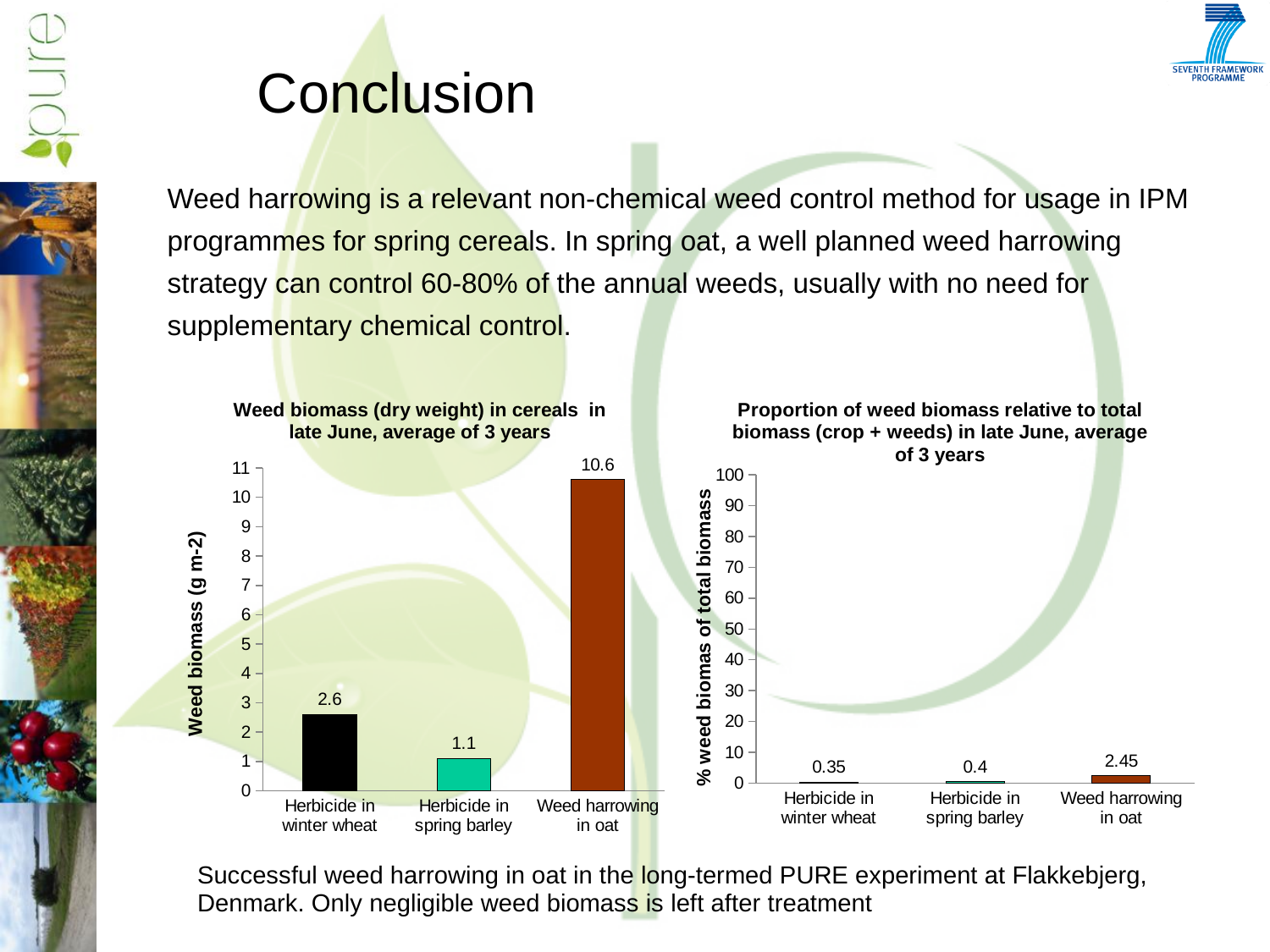
In the left chart (Weed biomass (dry weight) in cereals in late June), what is the y-axis label? Weed biomass (g m-2) In the left chart (Weed biomass (dry weight) in cereals in late June), which category has the lowest weed biomass? Herbicide in spring barley In the left chart (Weed biomass (dry weight) in cereals in late June), is the value for Weed harrowing in oat greater or less than 10? greater In the right chart (Proportion of weed biomass relative to total biomass), what is the value for Herbicide in winter wheat? 0.35 In the left chart (Weed biomass (dry weight) in cereals in late June), what is the value for Herbicide in spring barley? 1.1 In the right chart (Proportion of weed biomass relative to total biomass), which category has the highest value? Weed harrowing in oat In the left chart (Weed biomass (dry weight) in cereals in late June), what is the value for Weed harrowing in oat? 10.6 In the right chart (Proportion of weed biomass relative to total biomass), what is the difference between Herbicide in spring barley and Herbicide in winter wheat? 0.05 What kind of chart is the left chart (Weed biomass (dry weight) in cereals in late June)? bar chart In the right chart (Proportion of weed biomass relative to total biomass), what is the value for Weed harrowing in oat? 2.45 In the left chart (Weed biomass (dry weight) in cereals in late June), what is the difference between Weed harrowing in oat and Herbicide in winter wheat? 8 In the right chart (Proportion of weed biomass relative to total biomass), how many categories are shown? 3